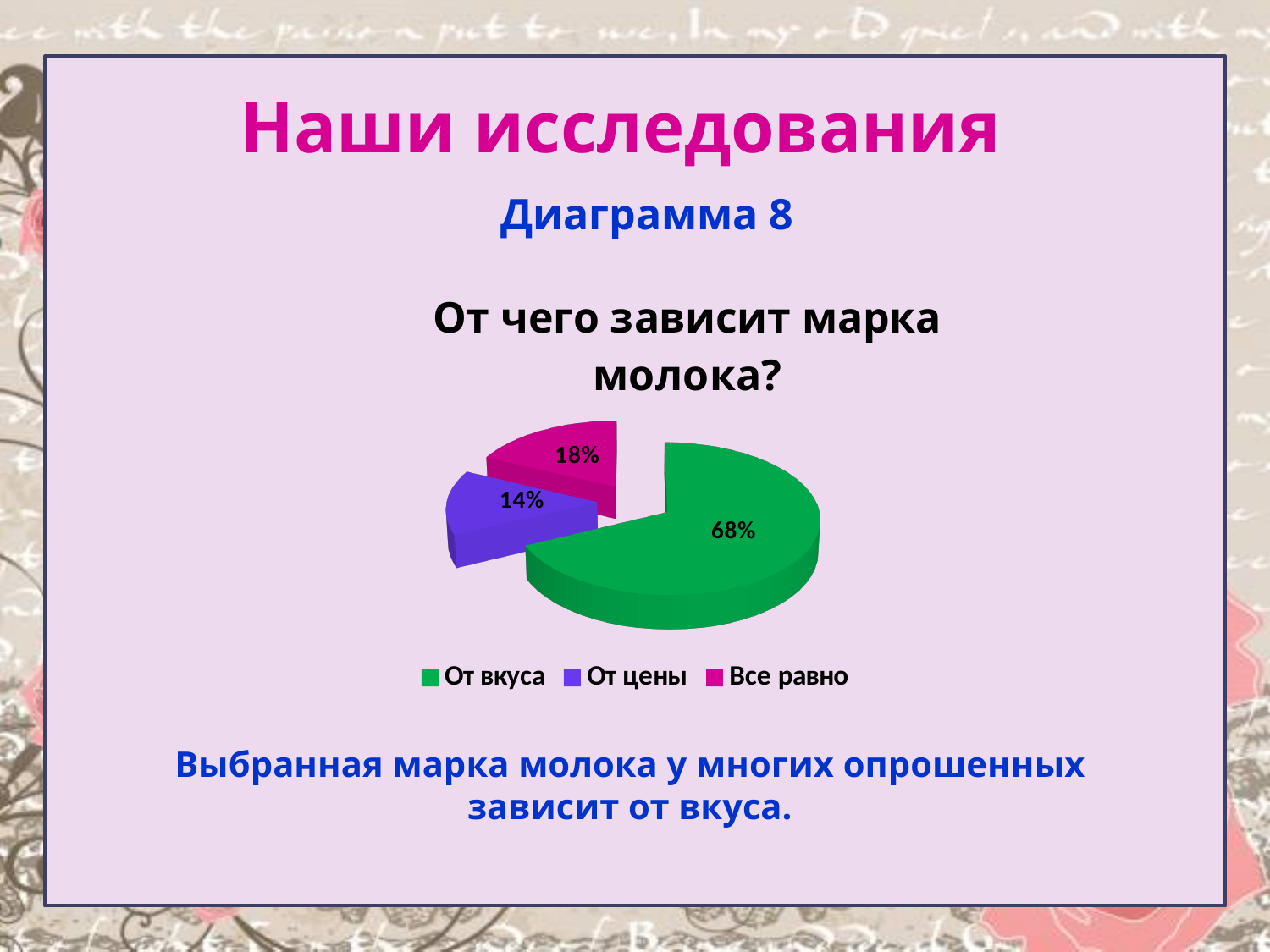
What is the difference between the shares of "Все равно" and "От цены"? 4% What share of the pie does "Все равно" take? 18% Which category has the smallest slice? От цены What is the difference between the shares of "От вкуса" and "Все равно"? 50% What kind of chart is shown on the slide? pie chart What is the chart's title? От чего зависит марка молока? What share of the pie does "От цены" take? 14% Which is larger, the share for "Все равно" or the share for "От цены"? Все равно How many categories does the pie chart have? 3 Which category has the largest slice? От вкуса What colour is the "От вкуса" slice? green What share of the pie does "От вкуса" take? 68%